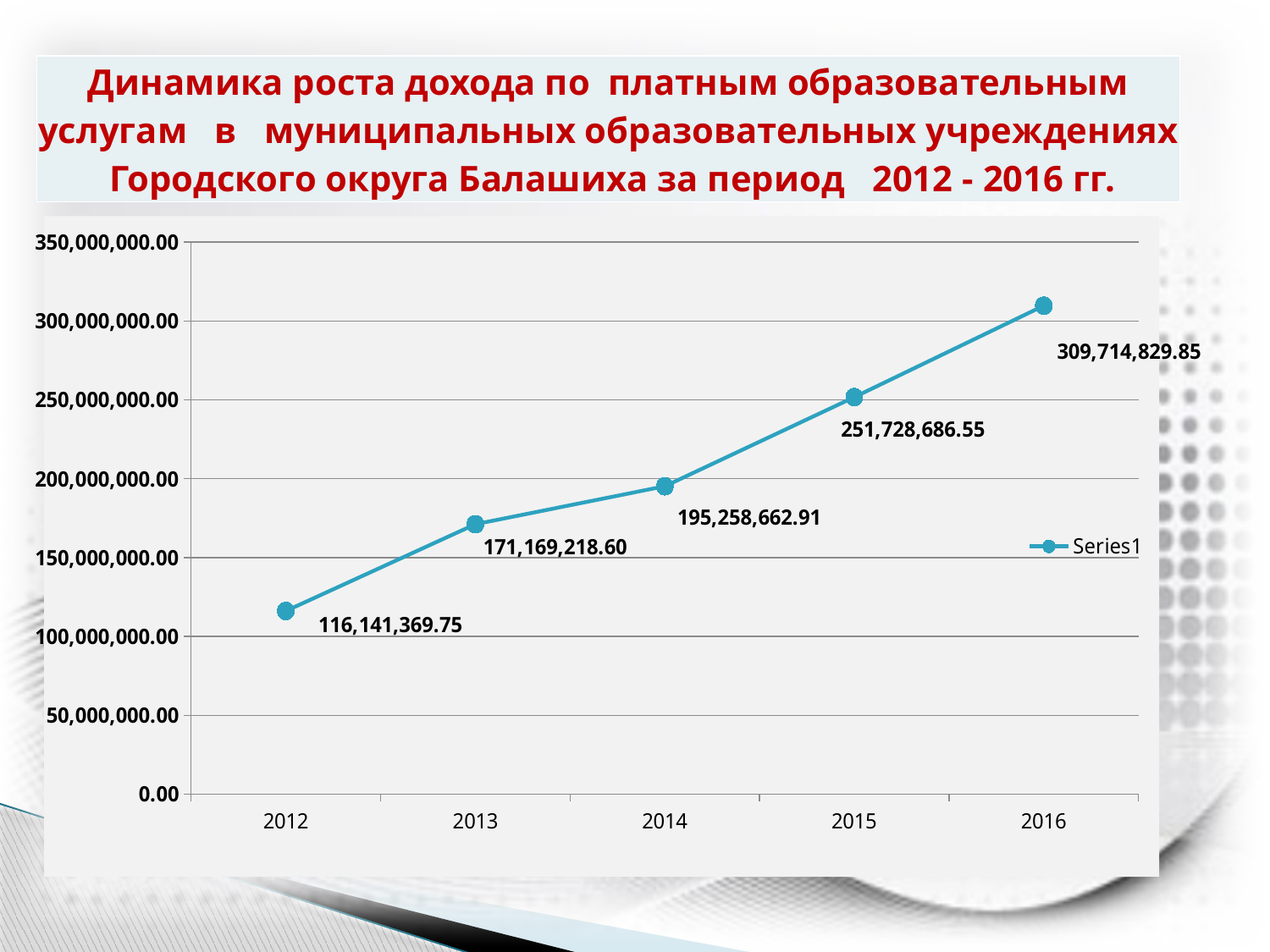
Do the values rise or fall from 2012 to 2016? rise What is the difference between the values for 2013 and 2012? 55,027,848.85 Which is larger, the value for 2015 or the value for 2014? 2015 What is the difference between the values for 2016 and 2012? 193,573,460.10 What is the value for 2014? 195,258,662.91 How many years are plotted on the x axis? 5 What is the value for 2012? 116,141,369.75 Which year has the lowest value? 2012 Which year has the highest value? 2016 What is the value for 2016? 309,714,829.85 Is the value for 2014 greater or less than 150,000,000.00? greater What kind of chart is shown on the slide? line chart